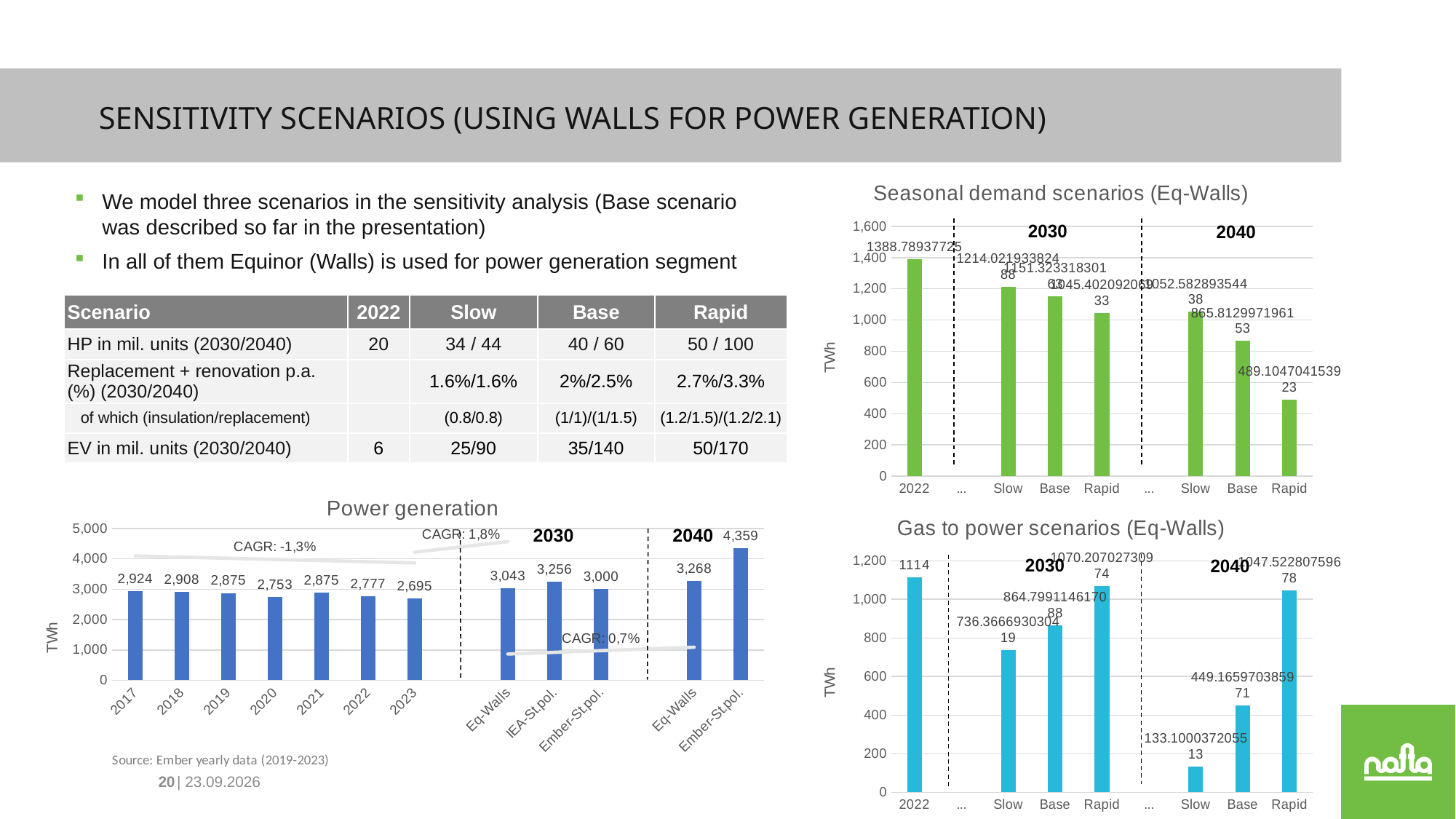
In the Seasonal demand scenarios (Eq-Walls) chart, is the value for the 2040 Rapid scenario greater or less than 600? less In the Power generation chart, do the values generally rise or fall from 2017 to 2023? fall In the Power generation chart, what is the difference between the 2030 IEA-St.pol. value and the 2030 Eq-Walls value? 213 What kind of chart is the Power generation chart? bar chart In the Gas to power scenarios (Eq-Walls) chart, which bar has the lowest value? Slow (2040) In the Gas to power scenarios (Eq-Walls) chart, is the value for the 2040 Base scenario greater or less than 400? greater In the Power generation chart, which bar has the highest value? Ember-St.pol. (2040) In the Power generation chart, what is the value for 2017? 2,924 In the Gas to power scenarios (Eq-Walls) chart, what is the value for 2022? 1114 How many bars are plotted in the Power generation chart? 12 In the Power generation chart, which year from 2017 to 2023 has the lowest value? 2023 In the Power generation chart, which is larger, the value for 2021 or the value for 2022? 2021